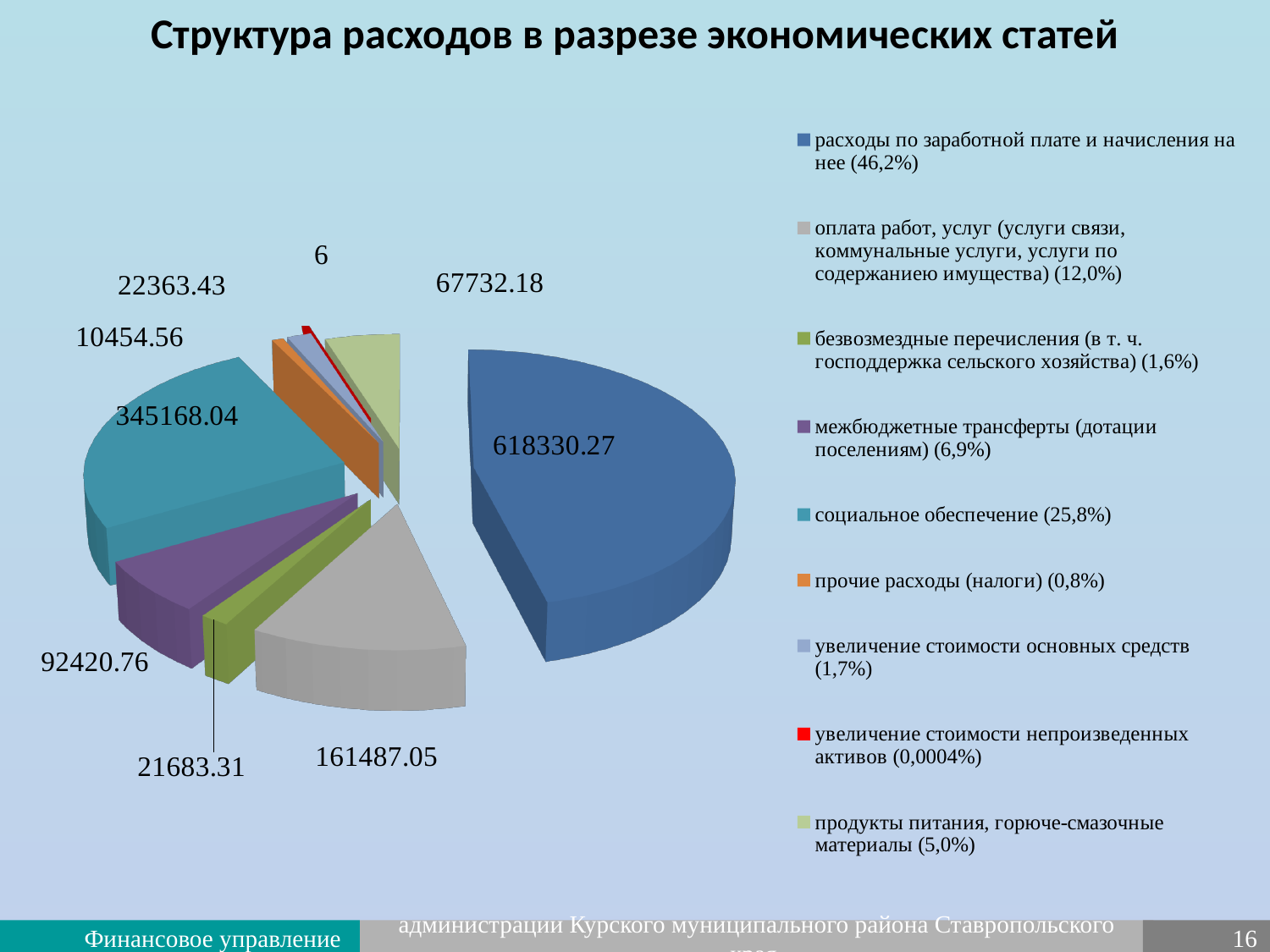
What is the difference between the values for расходы по заработной плате и начисления на нее and социальное обеспечение? 273162.23 Which category has the smallest slice of the pie? увеличение стоимости непроизведенных активов What is the value shown for межбюджетные трансферты (дотации поселениям)? 92420.76 What is the value shown for расходы по заработной плате и начисления на нее? 618330.27 What type of chart is shown on the slide? pie chart Which is larger: the value for социальное обеспечение or the value for оплата работ, услуг? социальное обеспечение What is the value shown for социальное обеспечение? 345168.04 What share of the pie does социальное обеспечение represent, according to the legend? 25,8% What is the value shown for оплата работ, услуг? 161487.05 What share of the pie does продукты питания, горюче-смазочные материалы represent, according to the legend? 5,0% Which category has the largest slice of the pie? расходы по заработной плате и начисления на нее How many categories does the legend of the pie chart list? 9